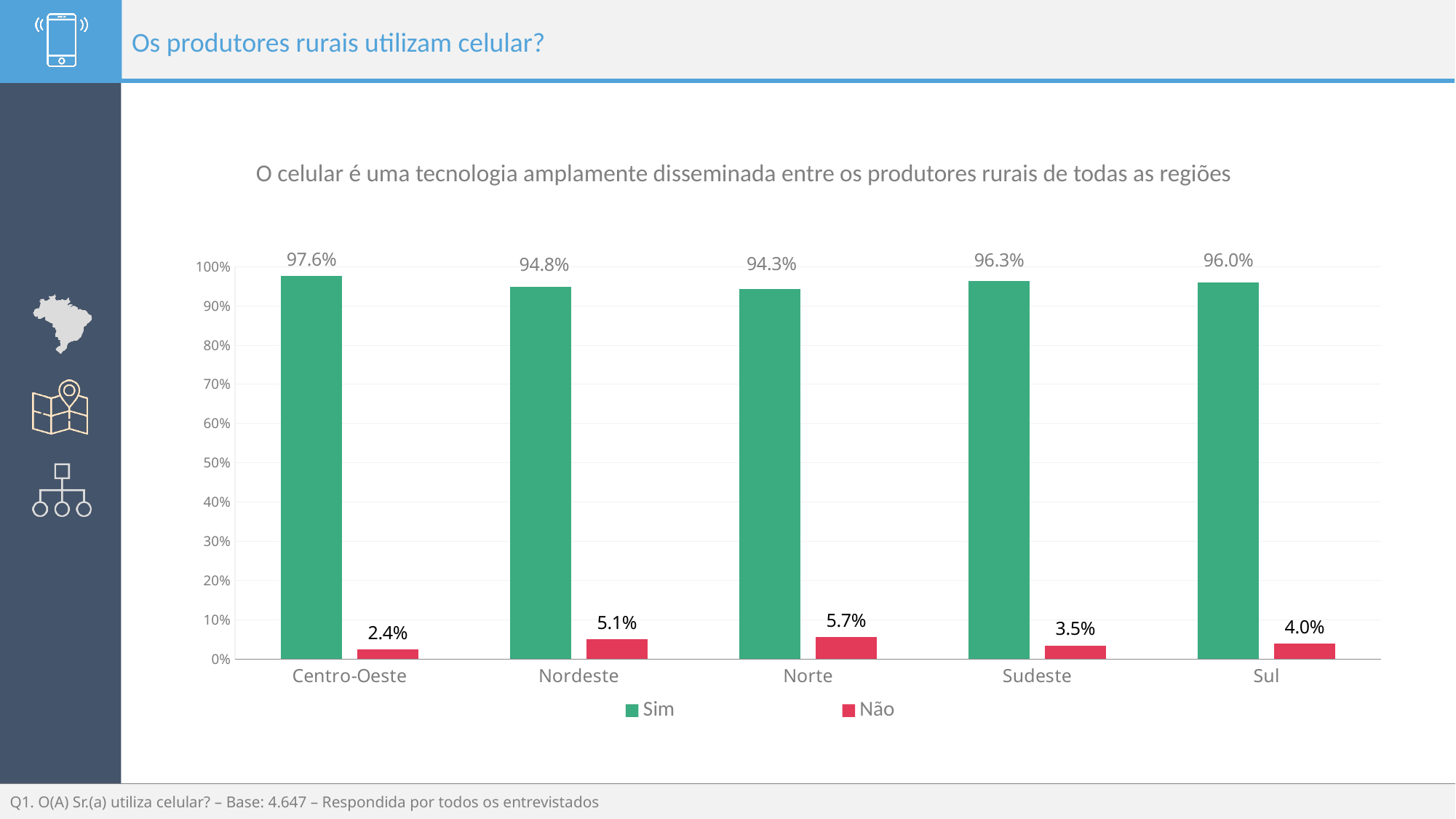
What is the difference between the 'Sim' values for Centro-Oeste and Norte? 3.3% What kind of chart is shown on the slide? Bar chart What is the 'Sim' value for Sul? 96.0% How many series does the legend list? 2 How many regions are shown on the x axis? 5 Which colour represents the 'Não' series in the legend? Red Which is larger, the 'Não' value for Nordeste or for Sudeste? Nordeste Which region has the highest 'Sim' value? Centro-Oeste Which region has the lowest 'Não' value? Centro-Oeste Which region has the highest 'Não' value? Norte What is the 'Não' value for Norte? 5.7% What is the 'Sim' value for Centro-Oeste? 97.6%